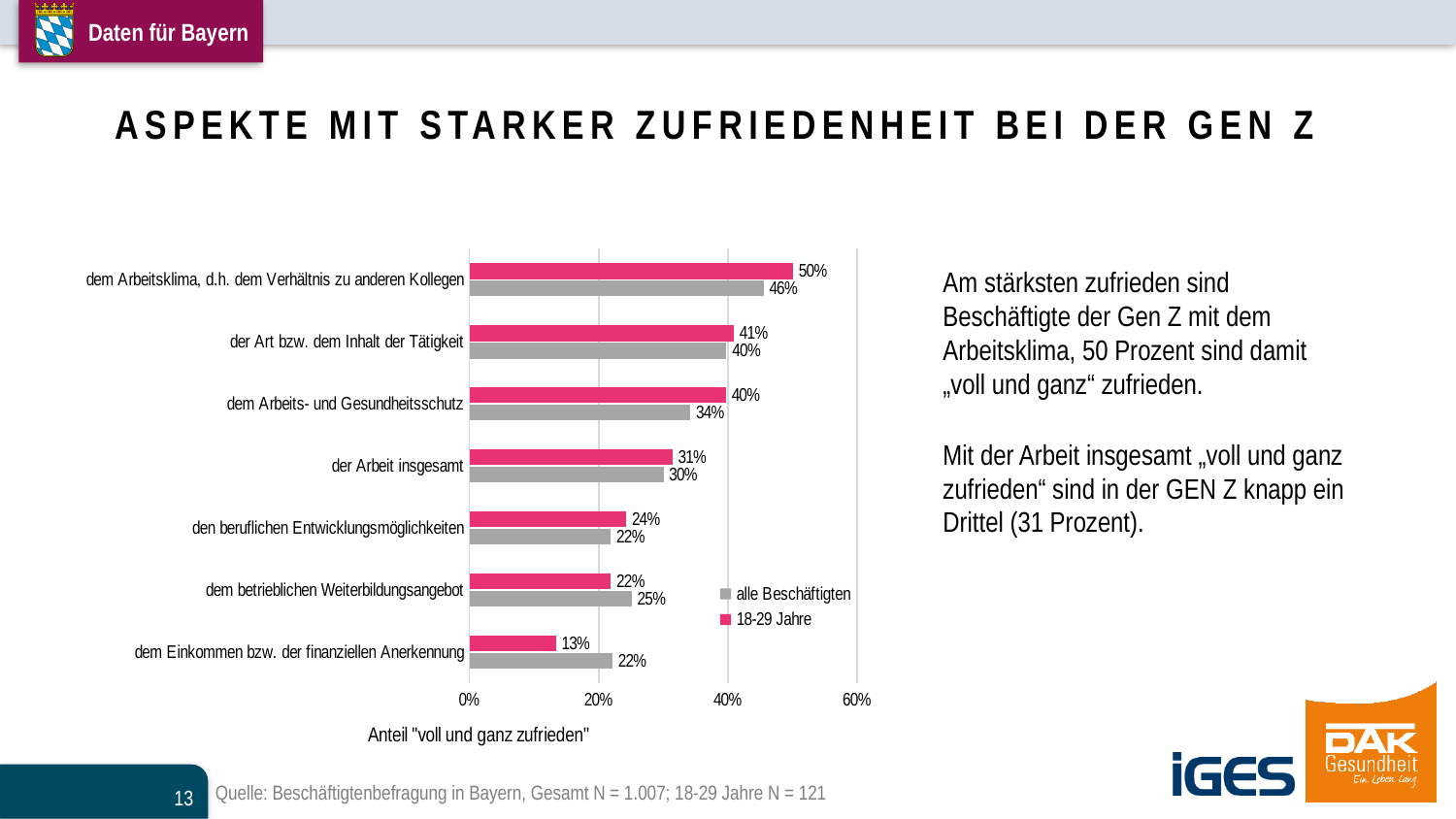
What is the value for "alle Beschäftigten" for "dem Einkommen bzw. der finanziellen Anerkennung"? 22% What is the value for "18-29 Jahre" for "dem Arbeitsklima, d.h. dem Verhältnis zu anderen Kollegen"? 50% For "dem betrieblichen Weiterbildungsangebot", which series has the larger value, "alle Beschäftigten" or "18-29 Jahre"? alle Beschäftigten Is the "18-29 Jahre" value for "der Arbeit insgesamt" greater or less than 20%? greater How many series does the legend list? 2 What is the difference between the "18-29 Jahre" and "alle Beschäftigten" values for "dem Arbeits- und Gesundheitsschutz"? 6% What is the value for "alle Beschäftigten" for "dem Arbeits- und Gesundheitsschutz"? 34% Which category has the highest value for "18-29 Jahre"? dem Arbeitsklima, d.h. dem Verhältnis zu anderen Kollegen How many categories are shown on the chart? 7 Which category has the lowest value for "18-29 Jahre"? dem Einkommen bzw. der finanziellen Anerkennung What is the label of the horizontal axis of the chart? Anteil "voll und ganz zufrieden" What kind of chart is shown on the slide? bar chart